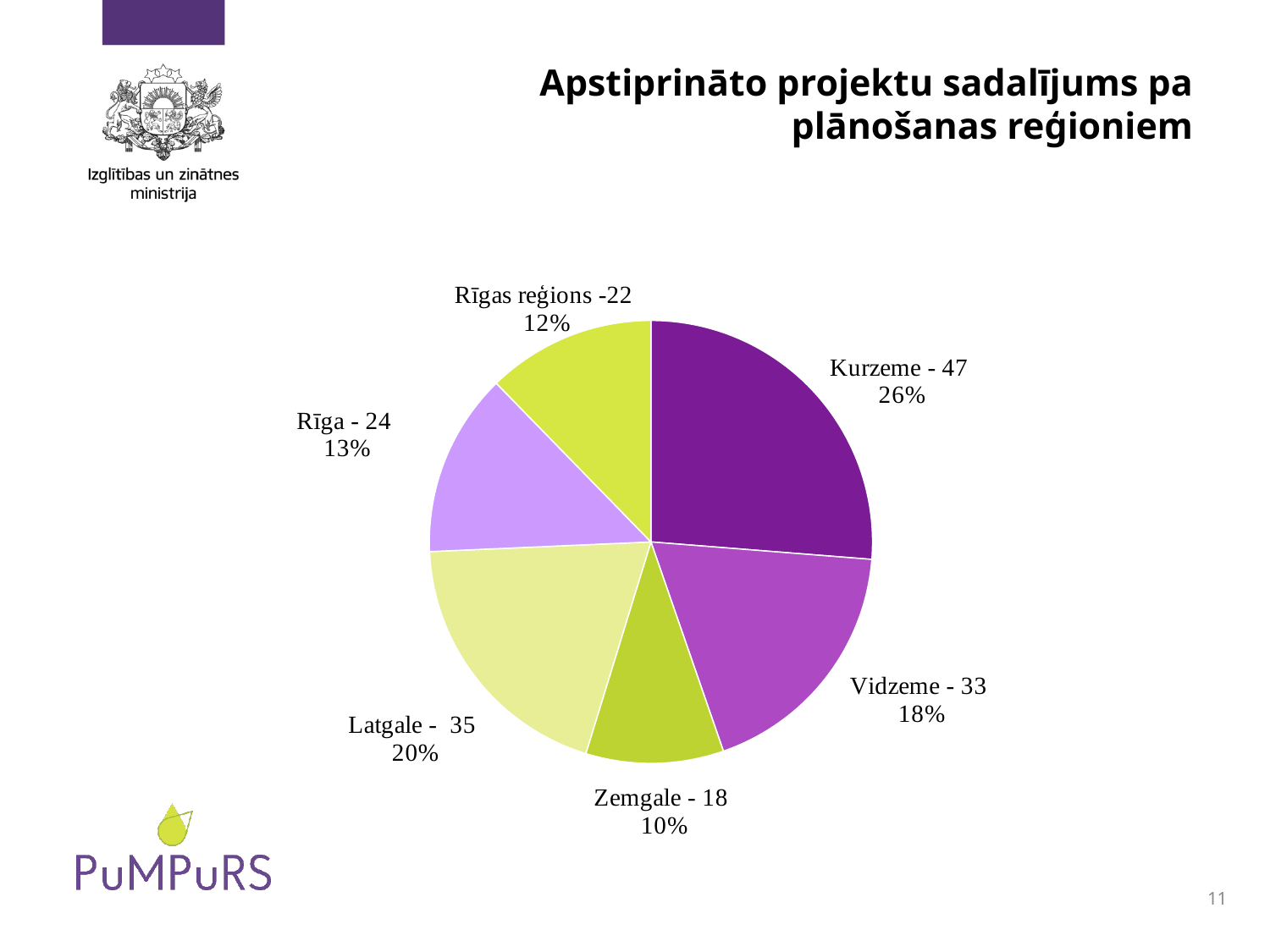
Which region has the smallest slice of the pie? Zemgale What share of the pie does Latgale represent? 20% What is the difference in the number of projects between Latgale and Vidzeme? 2 Which has more projects, Rīga or Rīgas reģions? Rīga How many approved projects are shown for Rīgas reģions? 22 How many approved projects are shown for Kurzeme? 47 What is the difference in the number of projects between Kurzeme and Zemgale? 29 What kind of chart is shown on the slide? pie chart What share of the pie does Vidzeme represent? 18% What is the title of the chart? Apstiprināto projektu sadalījums pa plānošanas reģioniem Which region has the largest slice of the pie? Kurzeme How many slices does the pie chart have? 6